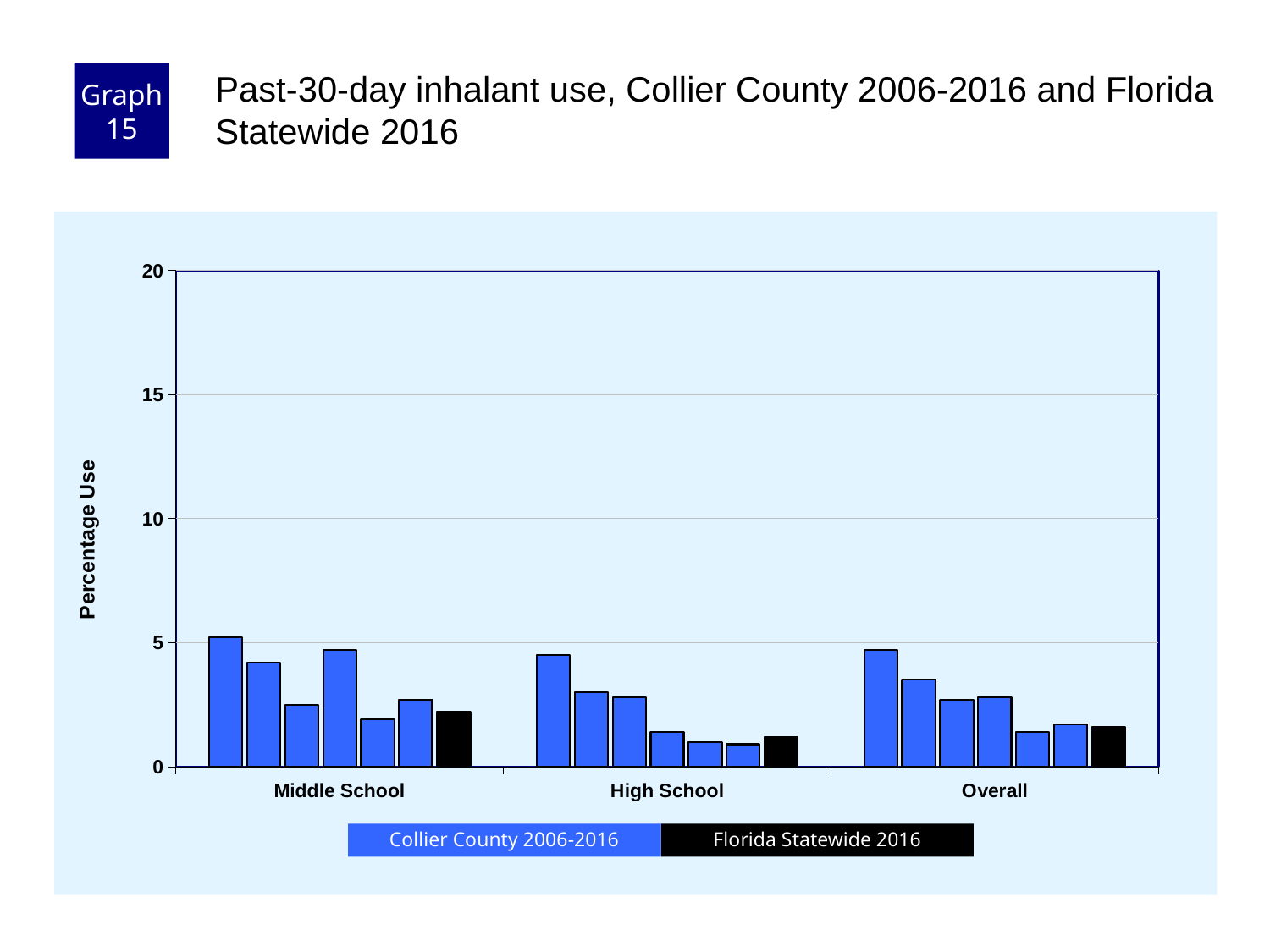
Is the Florida Statewide 2016 value for Middle School greater or less than 5? less What kind of chart is shown on the slide? bar chart Which is larger, the Florida Statewide 2016 value for Middle School or for High School? Middle School What is the title of the chart? Past-30-day inhalant use, Collier County 2006-2016 and Florida Statewide 2016 How many series does the legend list? 2 Which is larger, the Florida Statewide 2016 value for Middle School or for Overall? Middle School Is the Florida Statewide 2016 value for High School greater or less than 5? less Are any of the High School bars greater or less than 10? less How many school-level categories are shown on the x axis? 3 What is the label on the y axis? Percentage Use Among the three categories, which has the highest Florida Statewide 2016 value? Middle School